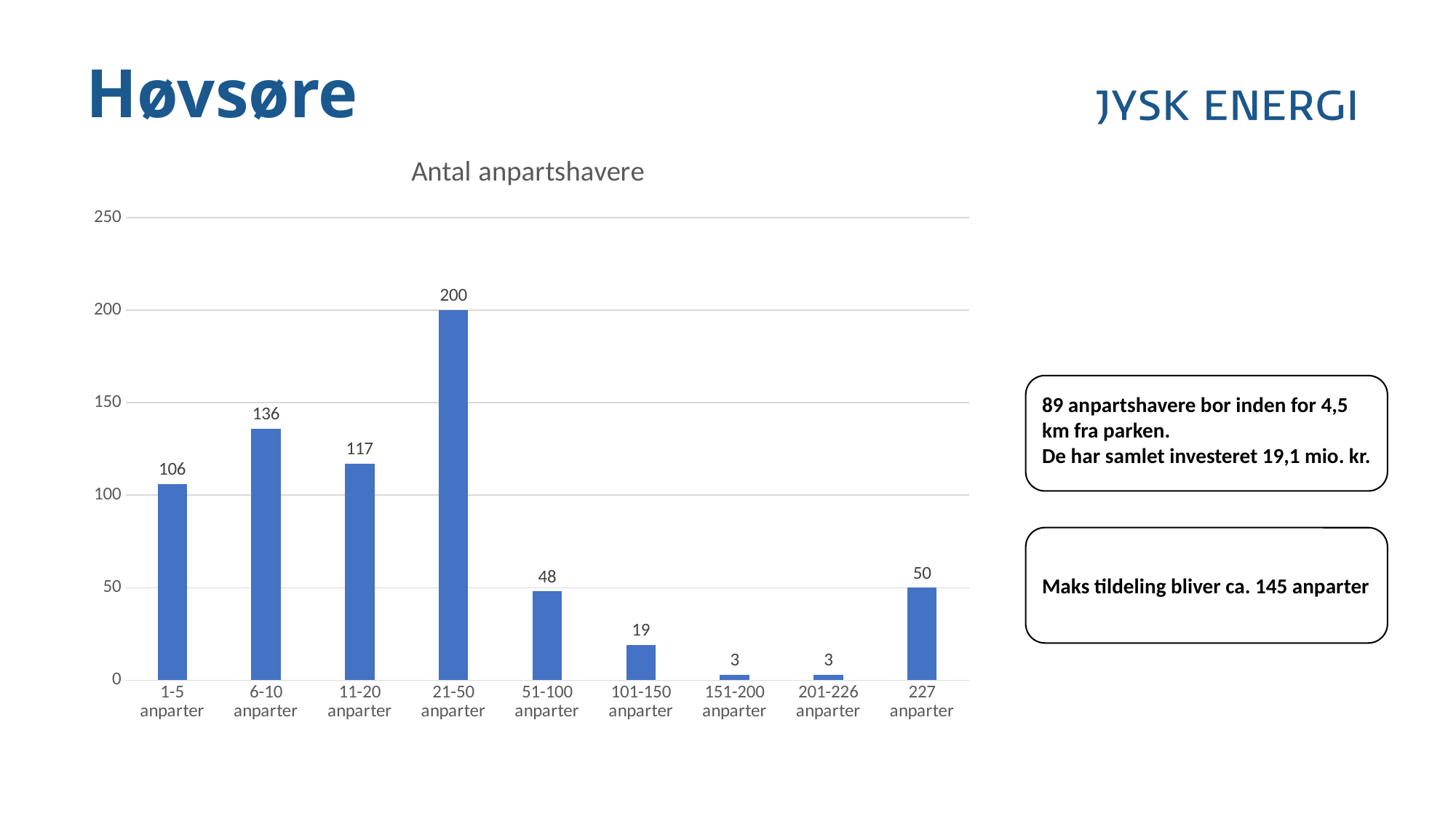
How many categories are shown on the x axis? 9 Is the value for 6-10 anparter greater or less than 150? less Which is larger, the value for 51-100 anparter or the value for 227 anparter? 227 anparter Which category has the highest value? 21-50 anparter What is the difference between the values for 21-50 anparter and 1-5 anparter? 94 What is the title of the chart? Antal anpartshavere What is the difference between the values for 6-10 anparter and 11-20 anparter? 19 What is the value for the 227 anparter category? 50 What is the value for the 21-50 anparter category? 200 What is the value for the 101-150 anparter category? 19 What kind of chart is shown on the slide? bar chart What is the value for the 1-5 anparter category? 106